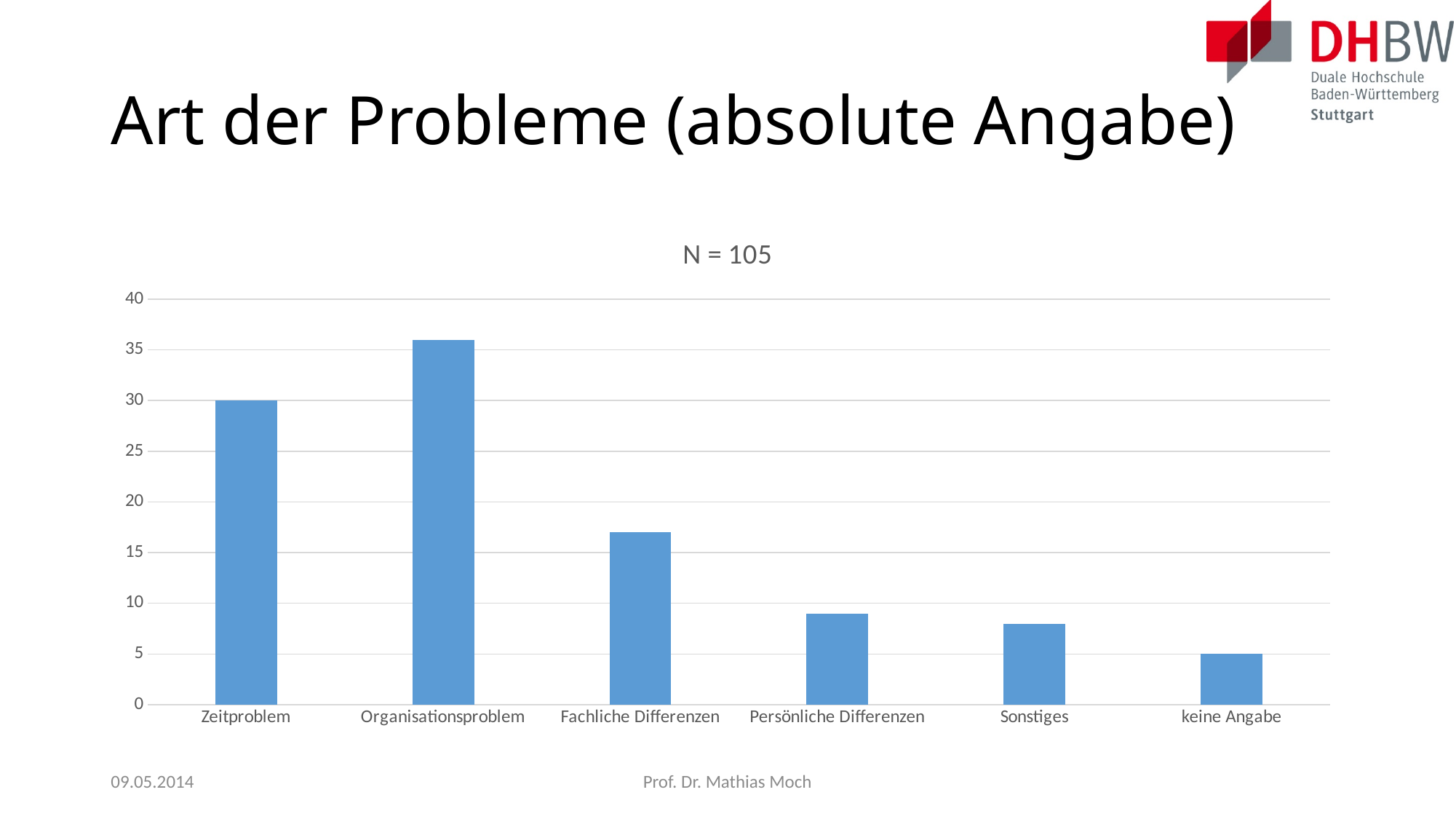
What is the value for Zeitproblem? 30 Which category has the lowest value in the chart? keine Angabe Is the value for Fachliche Differenzen greater or less than 20? less What is the value for keine Angabe? 5 What is the title shown above the chart? N = 105 Is the value for Organisationsproblem greater or less than 35? greater What type of chart is shown on the slide? bar chart How many categories are shown on the x axis of the chart? 6 Which category has the highest value in the chart? Organisationsproblem Which is larger, the value for Sonstiges or the value for keine Angabe? Sonstiges Which is larger, the value for Zeitproblem or the value for Fachliche Differenzen? Zeitproblem Is the value for Persönliche Differenzen greater or less than 10? less